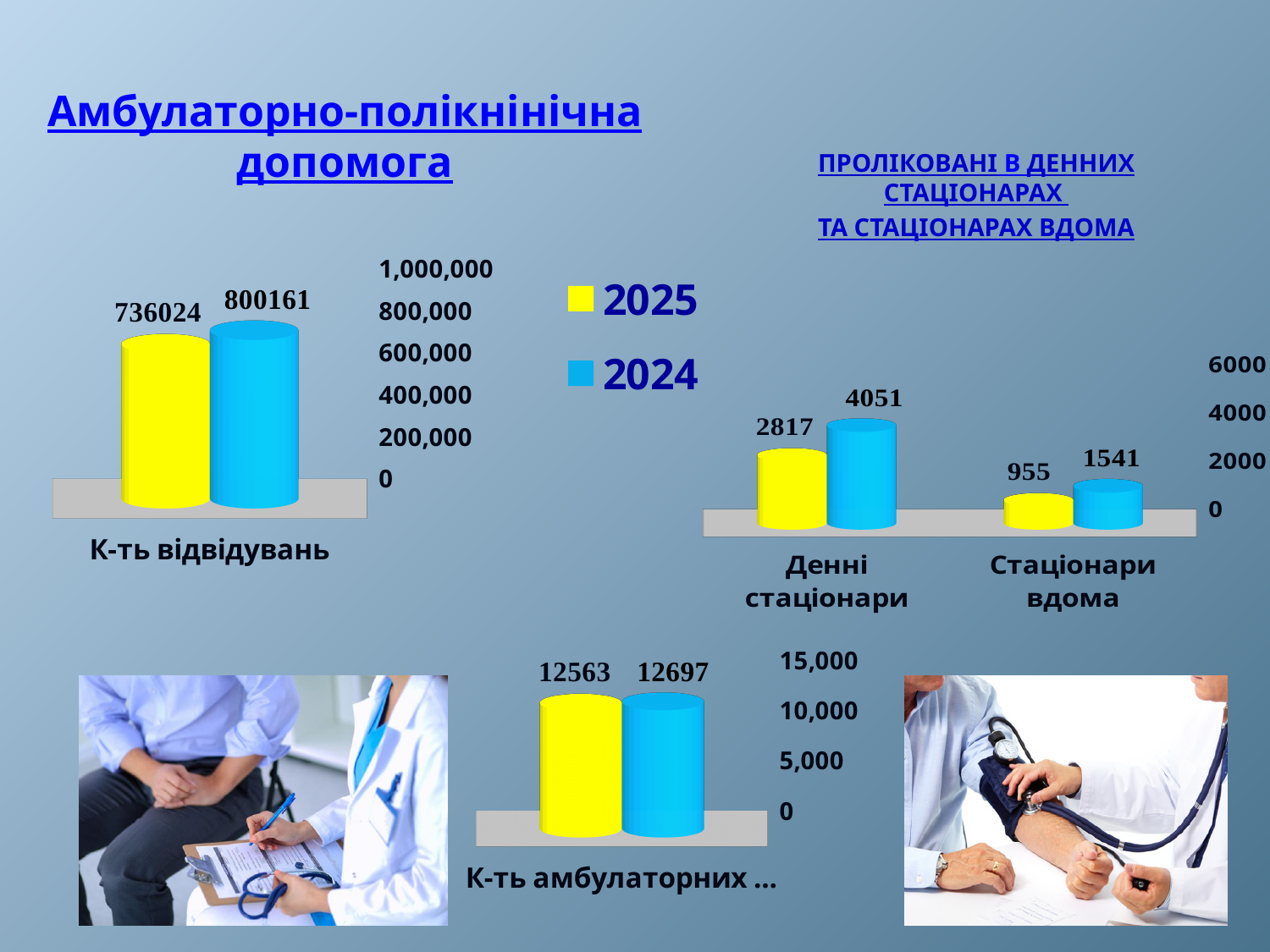
In the chart labelled "К-ть амбулаторних ..." at the bottom of the slide, which is larger, the 2024 value or the 2025 value? 2024 In the chart labelled "К-ть амбулаторних ..." at the bottom of the slide, what is the value of the 2025 bar? 12563 In the chart titled "Проліковані в денних стаціонарах та стаціонарах вдома", how many categories are shown on the x axis? 2 How many series does the legend list? 2 In the chart labelled "К-ть відвідувань", what is the value of the yellow (2025) bar? 736024 In the chart titled "Проліковані в денних стаціонарах та стаціонарах вдома", what is the 2024 value for Денні стаціонари? 4051 In the chart titled "Проліковані в денних стаціонарах та стаціонарах вдома", what is the difference between the 2024 and 2025 values for Денні стаціонари? 1234 In the chart titled "Проліковані в денних стаціонарах та стаціонарах вдома", which category has the highest value? Денні стаціонари In the chart titled "Проліковані в денних стаціонарах та стаціонарах вдома", what is the 2025 value for Стаціонари вдома? 955 In the chart labelled "К-ть відвідувань", what is the value of the blue (2024) bar? 800161 In the chart labelled "К-ть відвідувань", what is the difference between the 2024 and 2025 values? 64137 What type of chart is the one labelled "К-ть відвідувань"? Bar chart